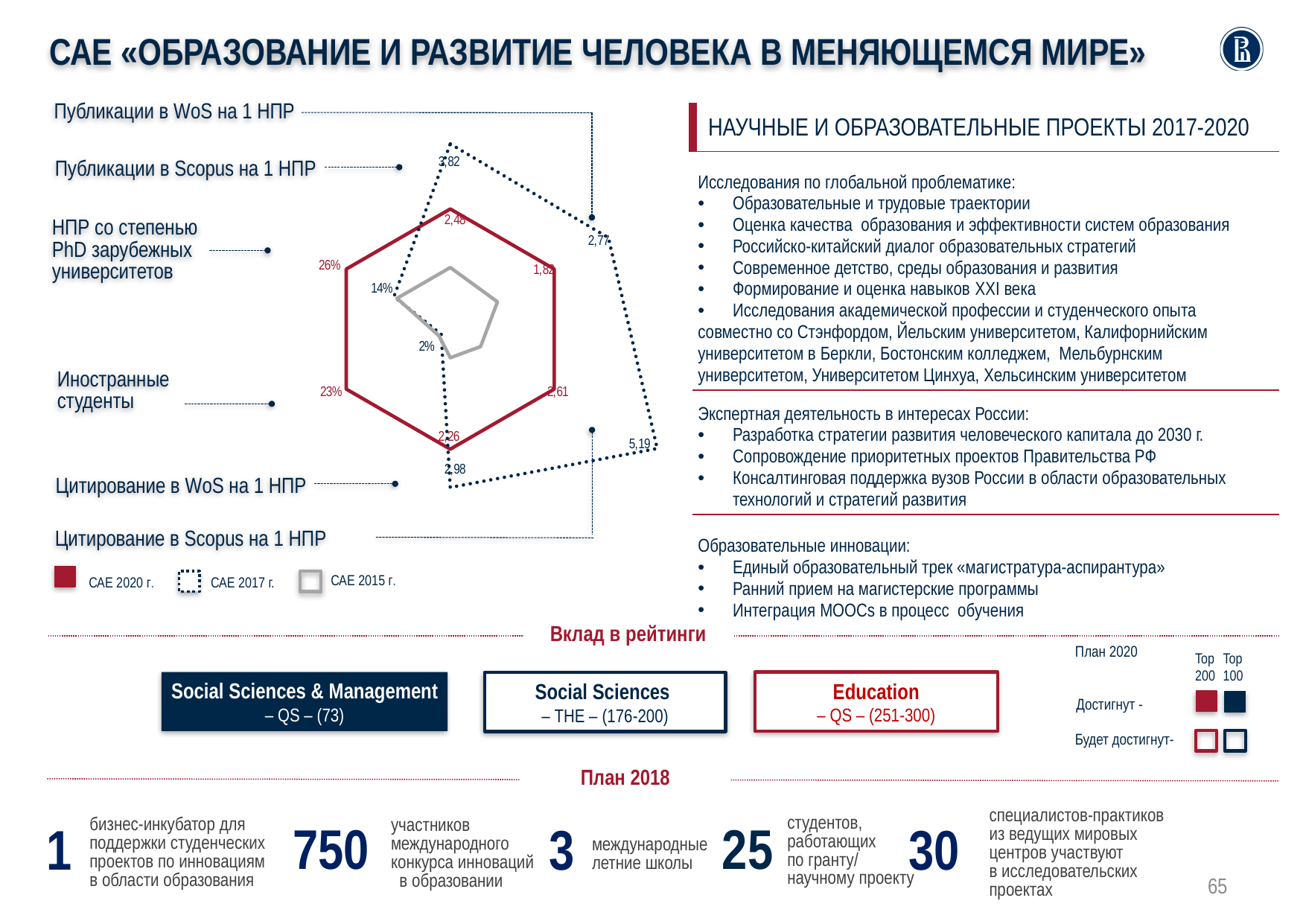
How many axes (indicators) does the radar chart have? 6 What kind of chart is shown on the left of the slide? Radar chart What is the value for Цитирование в Scopus на 1 НПР for САЕ 2017 г.? 5,19 How many series does the legend of the radar chart list? 3 Which series are listed in the legend of the radar chart? САЕ 2020 г., САЕ 2017 г., САЕ 2015 г. What is the value for НПР со степенью PhD зарубежных университетов for САЕ 2020 г.? 26% Which series has the larger value for Цитирование в Scopus на 1 НПР, САЕ 2017 г. or САЕ 2020 г.? САЕ 2017 г. What is the value for Публикации в Scopus на 1 НПР for САЕ 2017 г.? 3,82 What is the difference between the САЕ 2017 г. and САЕ 2020 г. values for Публикации в Scopus на 1 НПР? 1,34 What is the value for Публикации в Scopus на 1 НПР for САЕ 2020 г.? 2,48